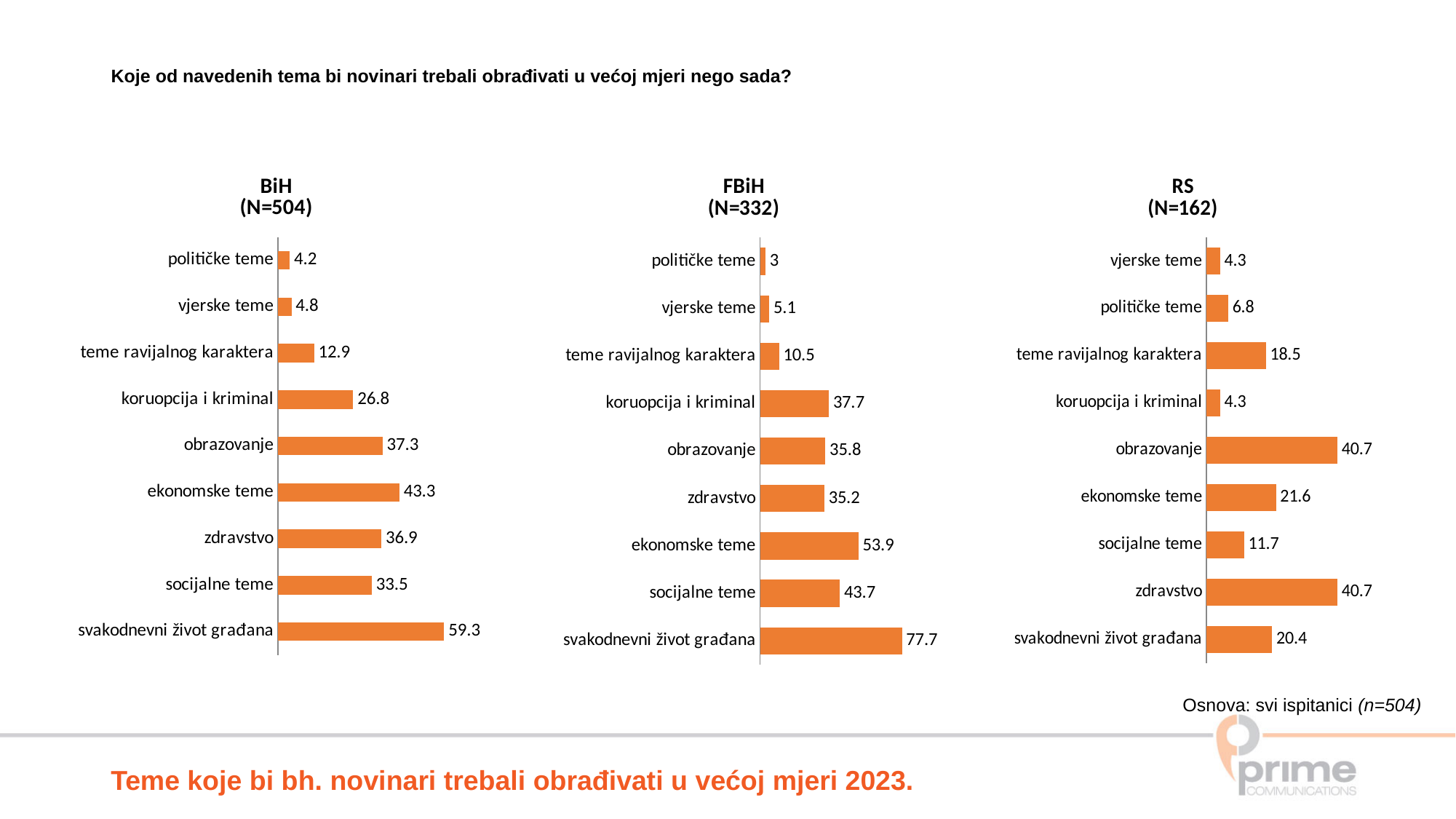
In the FBiH (N=332) chart, which category has the lowest value? političke teme How many categories are shown in the BiH (N=504) chart? 9 In the BiH (N=504) chart, what is the value for svakodnevni život građana? 59.3 In the BiH (N=504) chart, what is the difference between the values for ekonomske teme and zdravstvo? 6.4 In the RS (N=162) chart, which is larger: the value for ekonomske teme or the value for svakodnevni život građana? ekonomske teme In the FBiH (N=332) chart, what is the value for ekonomske teme? 53.9 What kind of chart is the RS (N=162) chart? bar chart In the RS (N=162) chart, what is the difference between the values for ekonomske teme and socijalne teme? 9.9 In the FBiH (N=332) chart, which category has the highest value? svakodnevni život građana In the FBiH (N=332) chart, which is larger: the value for koruopcija i kriminal or the value for socijalne teme? socijalne teme In the BiH (N=504) chart, which category has the lowest value? političke teme In the RS (N=162) chart, what is the value for teme ravijalnog karaktera? 18.5